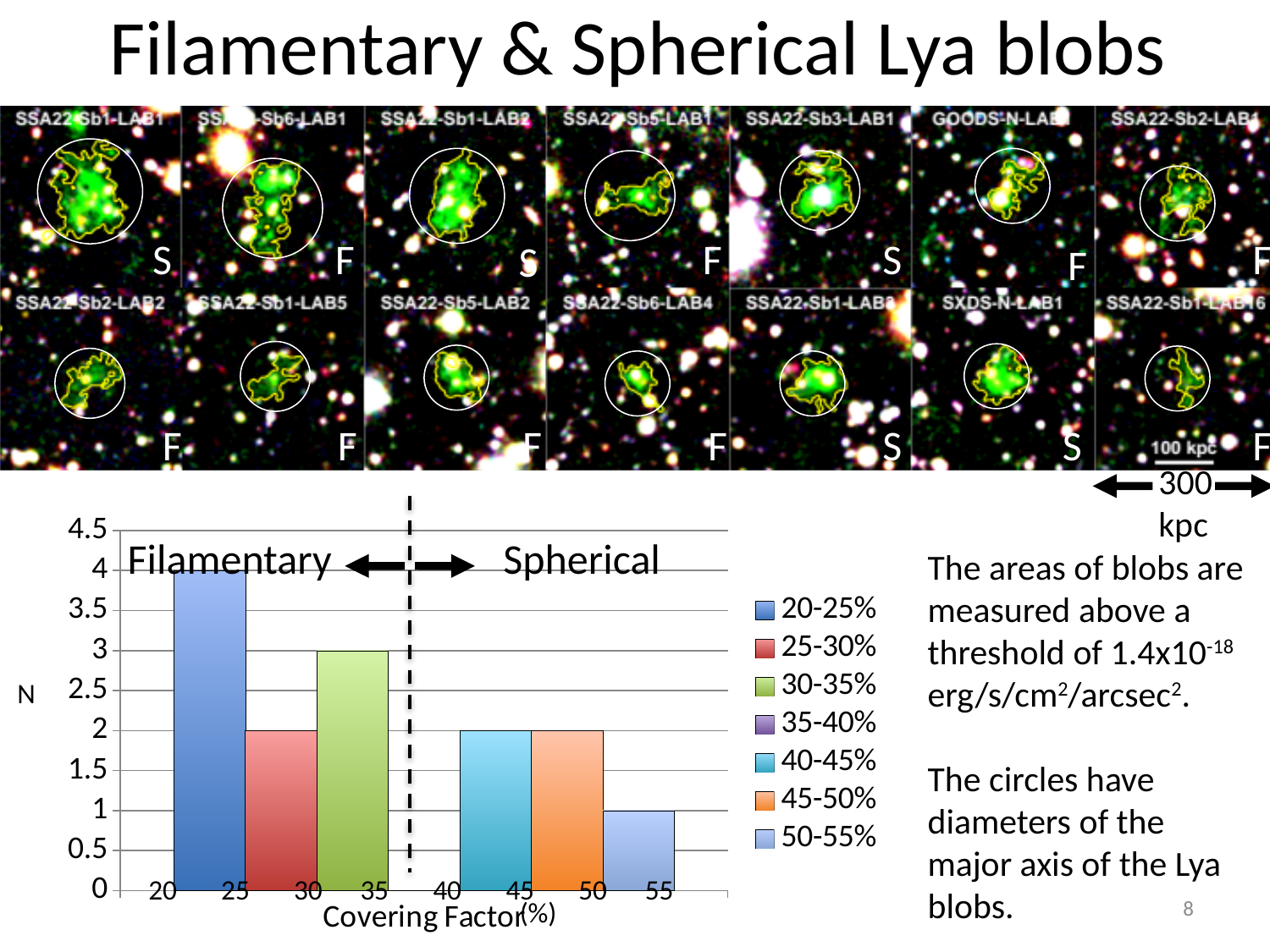
What is the total N across the three Filamentary bins (20-25%, 25-30%, 30-35%)? 9 Which has a larger N, the 30-35% bin or the 40-45% bin? 30-35% What is the value of N for the 45-50% covering factor bin? 2 What type of chart is shown on the slide? bar chart Which covering factor bin has the highest N? 20-25% What is the label of the y axis? N What is the value of N for the 20-25% covering factor bin? 4 How many entries does the legend list? 7 What is the value of N for the 30-35% covering factor bin? 3 What is the label of the x axis? Covering Factor (%) What is the value of N for the 50-55% covering factor bin? 1 What is the difference in N between the 20-25% bin and the 25-30% bin? 2